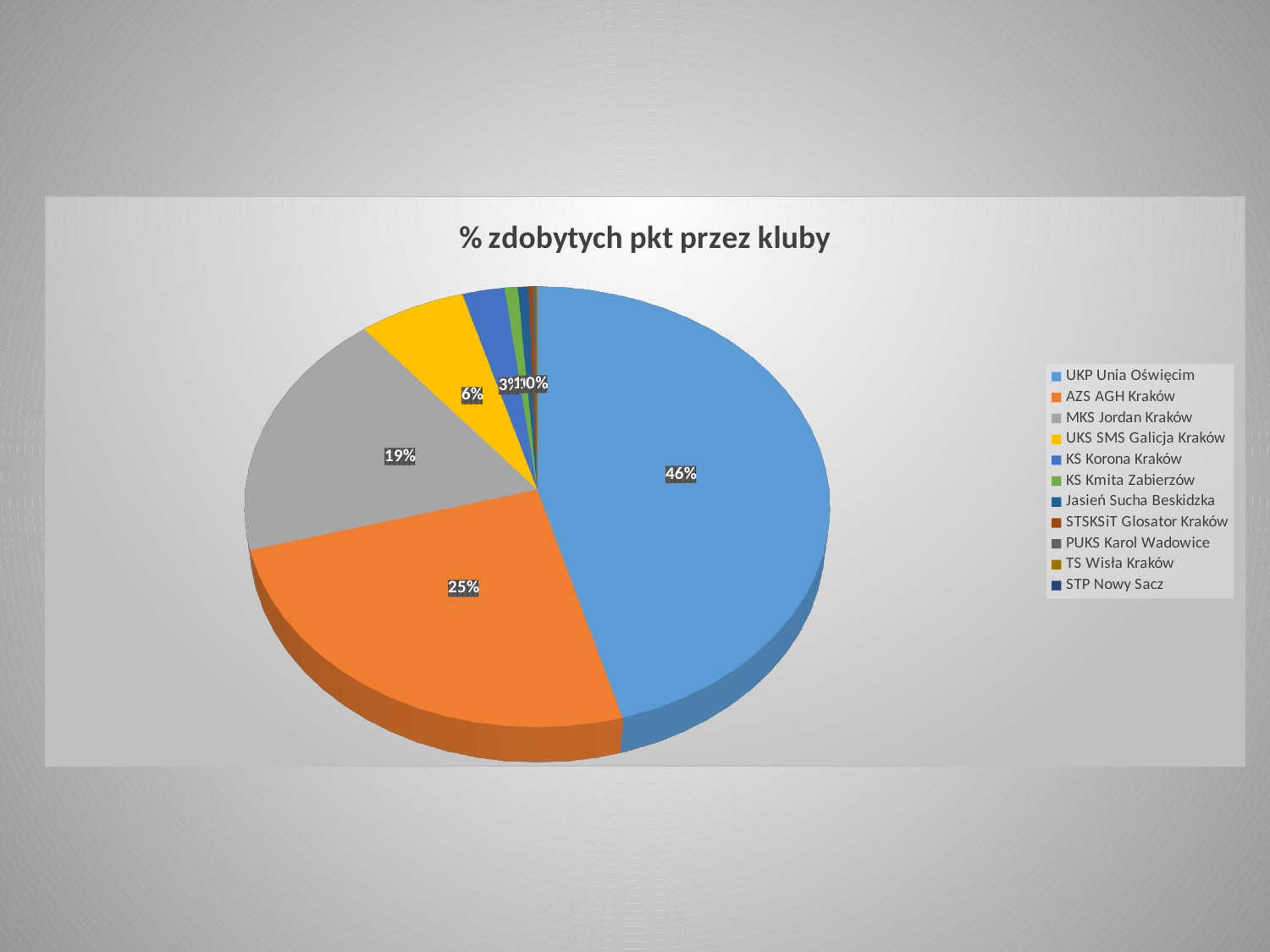
What is the title of the chart? % zdobytych pkt przez kluby What percentage of points is attributed to MKS Jordan Kraków? 19% Which club has the largest share of the pie? UKP Unia Oświęcim Which has a larger share, MKS Jordan Kraków or UKS SMS Galicja Kraków? MKS Jordan Kraków What percentage of points is attributed to UKP Unia Oświęcim? 46% What type of chart is shown on the slide? pie chart What is the difference in percentage points between UKP Unia Oświęcim and AZS AGH Kraków? 21 What colour is the slice for AZS AGH Kraków? orange What percentage of points is attributed to AZS AGH Kraków? 25% How many clubs are listed in the legend? 11 What is the difference in percentage points between AZS AGH Kraków and MKS Jordan Kraków? 6 What percentage of points is attributed to UKS SMS Galicja Kraków? 6%